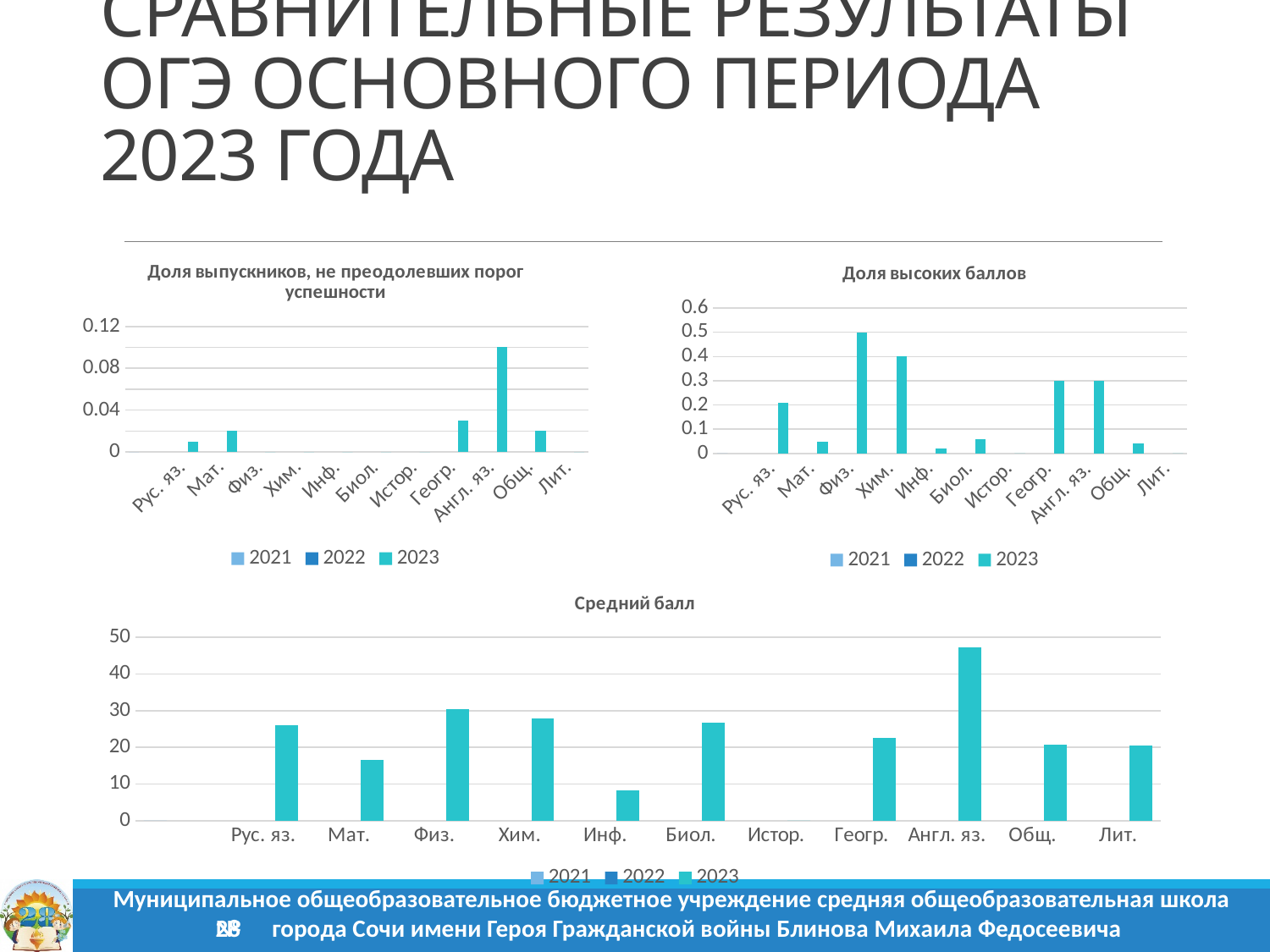
How many subject categories are shown on the x axis of the "Средний балл" chart? 11 What kind of chart is the "Средний балл" chart? bar chart In the "Доля высоких баллов" chart, what is the value for Физ.? 0.5 In the "Средний балл" chart, is the value for Англ. яз. greater or less than 40? greater In the "Средний балл" chart, which subject has the highest value? Англ. яз. In the "Средний балл" chart, which is larger, the value for Мат. or the value for Инф.? Мат. In the "Доля высоких баллов" chart, which subject has the highest value? Физ. How many series does the legend of the "Доля высоких баллов" chart list? 3 In the "Доля высоких баллов" chart, what is the value for Хим.? 0.4 In the "Доля выпускников, не преодолевших порог успешности" chart, is the value for Англ. яз. greater or less than 0.08? greater In the "Доля выпускников, не преодолевших порог успешности" chart, which subject has the highest value? Англ. яз. In the "Средний балл" chart, is the value for Инф. greater or less than 10? less